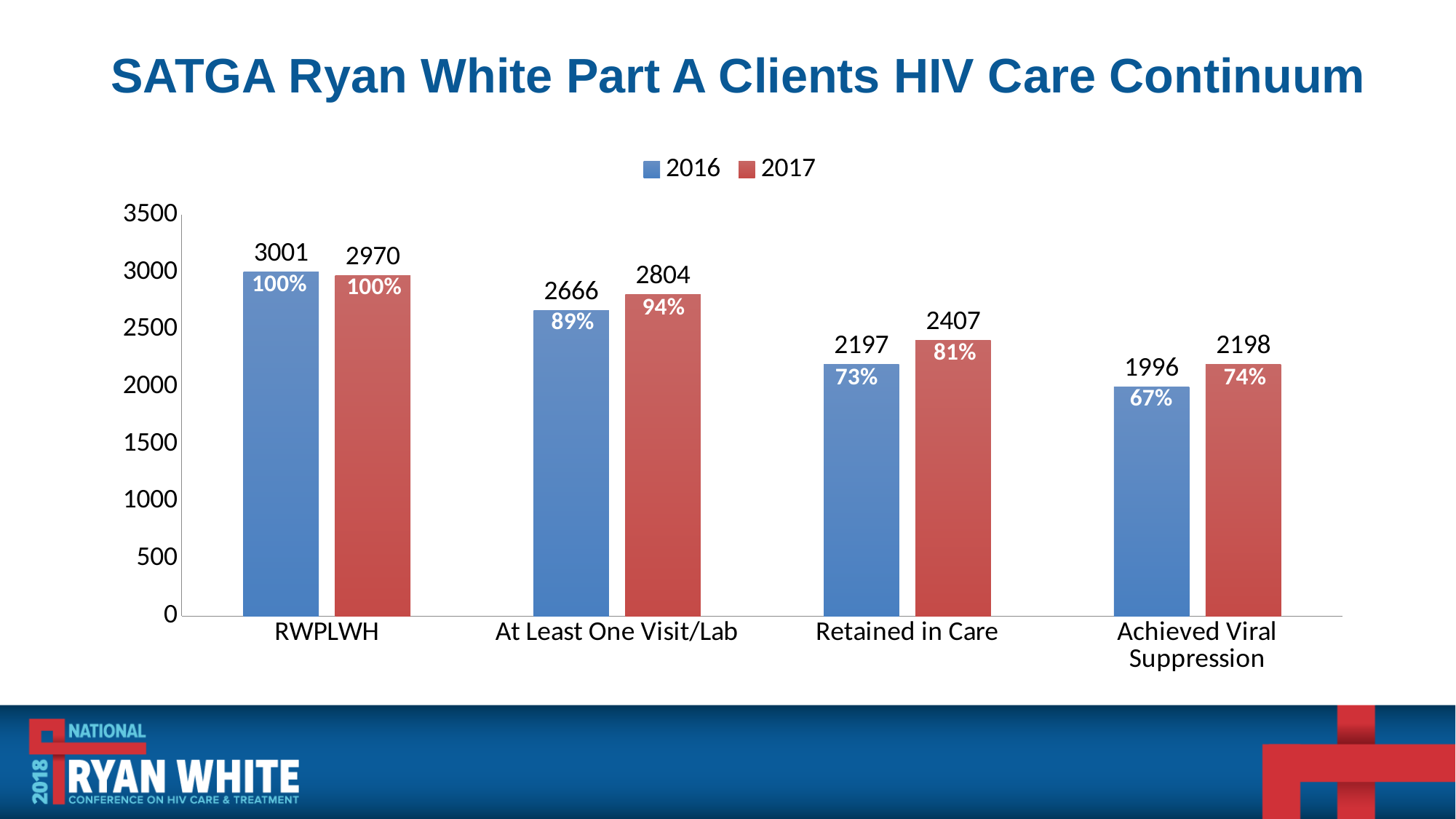
What is the difference between the 2017 and 2016 values for Retained in Care? 210 What kind of chart is shown on the slide? Bar chart Which category has the highest 2017 value? RWPLWH Which is larger for At Least One Visit/Lab, the 2016 value or the 2017 value? 2017 Do the 2017 values rise or fall moving from RWPLWH to Achieved Viral Suppression? Fall What is the 2017 value for At Least One Visit/Lab? 2804 Which category has the lowest 2016 value? Achieved Viral Suppression How many series does the legend list? 2 What is the difference between the 2016 and 2017 values for RWPLWH? 31 How many categories are shown on the x axis? 4 What is the 2016 value for Retained in Care? 2197 What percentage is shown on the 2017 bar for Achieved Viral Suppression? 74%